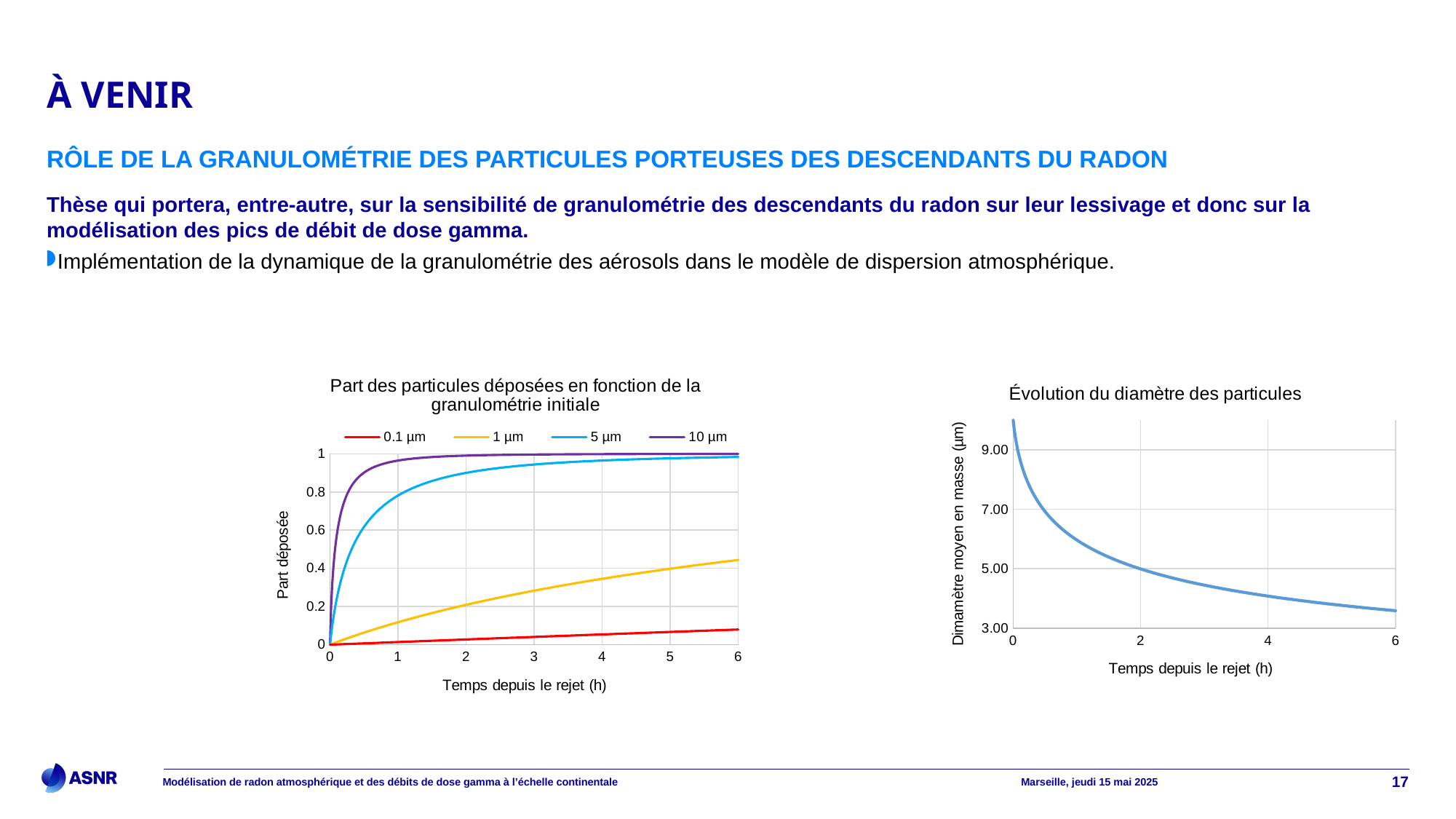
In the left chart, which series has the lowest deposited fraction at 6 h? 0.1 µm In the left chart, is the value of the 1 µm series at 6 h greater or less than 0.4? greater In the left chart, do the values of the 1 µm series rise or fall as time since release increases? rise How many series does the legend of the left chart list? 4 What type of chart is the left chart titled 'Part des particules déposées en fonction de la granulométrie initiale'? line chart In the left chart, is the value of the 10 µm series at 1 h greater or less than 0.8? greater What is the x-axis label of the right chart titled 'Évolution du diamètre des particules'? Temps depuis le rejet (h) In the left chart, at 3 h, which series has the larger deposited fraction: 1 µm or 0.1 µm? 1 µm In the left chart, is the value of the 0.1 µm series at 6 h greater or less than 0.2? less In the right chart 'Évolution du diamètre des particules', does the mean diameter rise or fall as time since release increases? fall